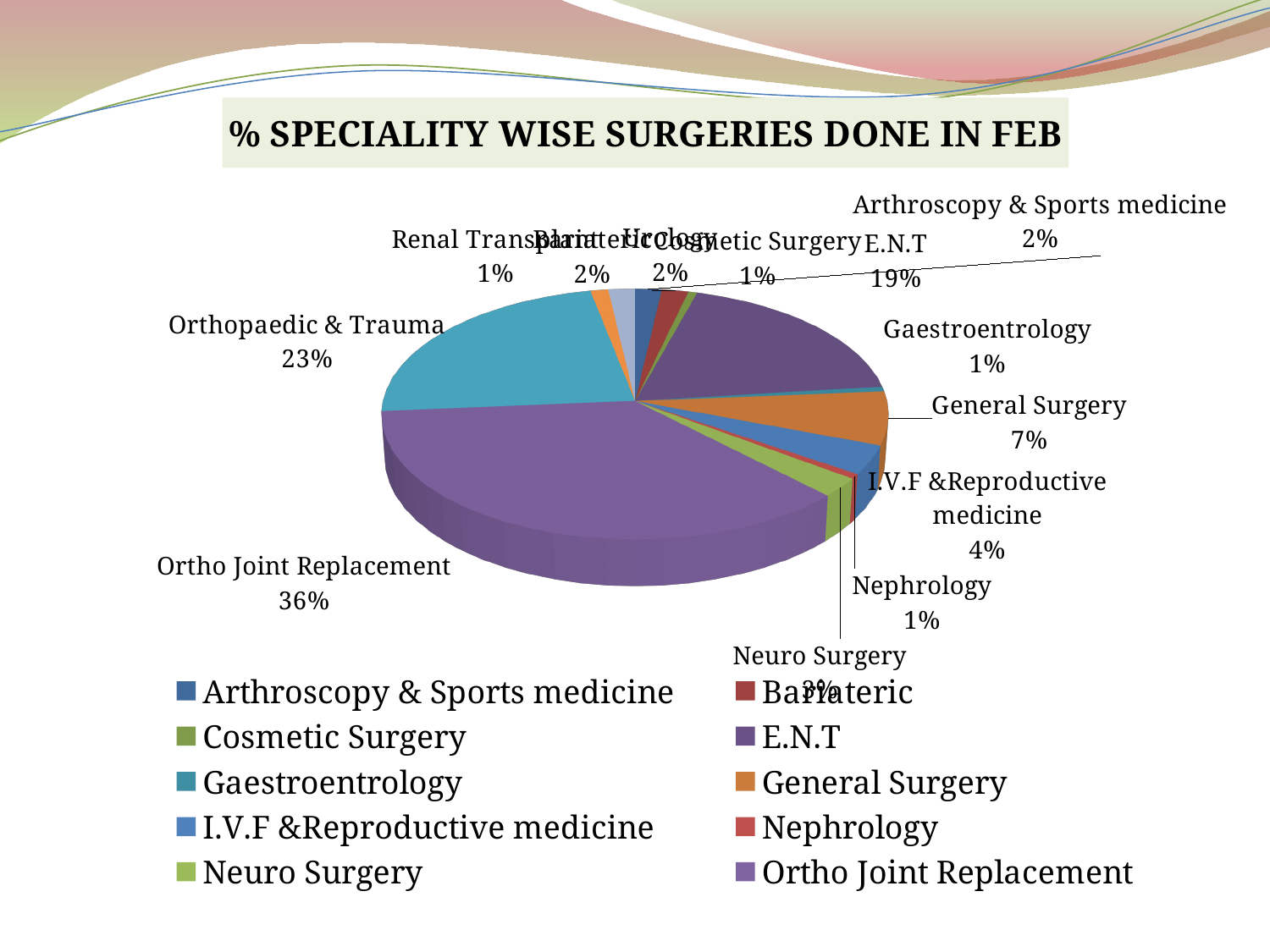
What percentage is shown for I.V.F & Reproductive medicine? 4% What percentage is shown for General Surgery? 7% Which speciality has the largest share of surgeries? Ortho Joint Replacement What is the title of the chart? % SPECIALITY WISE SURGERIES DONE IN FEB What percentage of surgeries were Ortho Joint Replacement? 36% What percentage of surgeries were Orthopaedic & Trauma? 23% What is the difference in percentage points between Ortho Joint Replacement and Orthopaedic & Trauma? 13 percentage points Which has a larger share, E.N.T or General Surgery? E.N.T What percentage is shown for Nephrology? 1% What share of surgeries does E.N.T account for? 19% What percentage is shown for Gaestroentrology? 1% What type of chart is shown on the slide? Pie chart